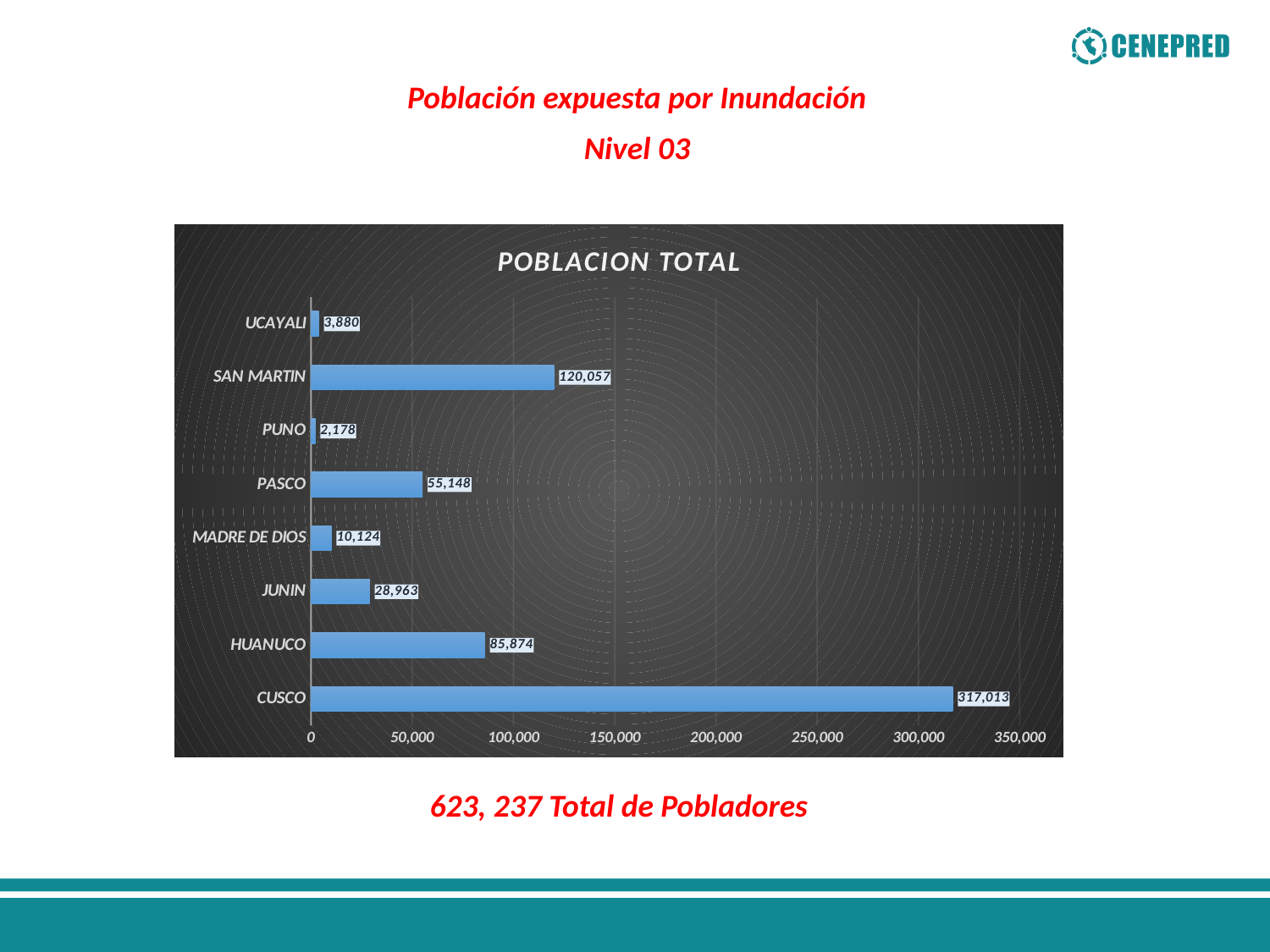
What is the difference between the values for CUSCO and SAN MARTIN? 196,956 What is the value for CUSCO? 317,013 How many categories are shown in the chart? 8 What kind of chart is shown on the slide? Bar chart Which category has the highest value? CUSCO What is the value for SAN MARTIN? 120,057 What is the value for PUNO? 2,178 What is the title of the chart? POBLACION TOTAL What is the difference between the values for HUANUCO and PASCO? 30,726 Which category has the lowest value? PUNO Which is larger, the value for JUNIN or the value for PASCO? PASCO What is the value for MADRE DE DIOS? 10,124